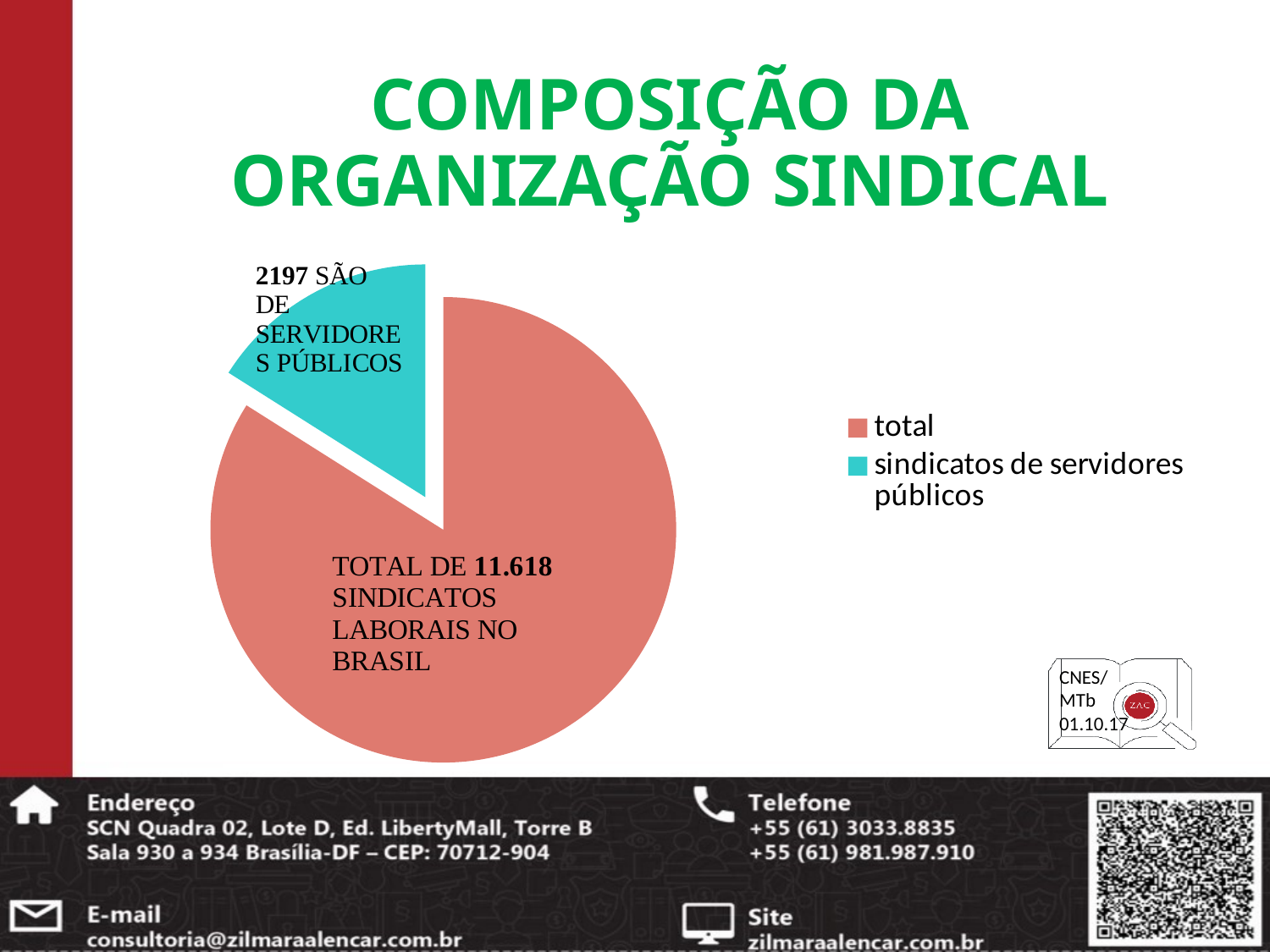
Which is larger in the pie chart: 'total' or 'sindicatos de servidores públicos'? total What value is printed for the 'sindicatos de servidores públicos' slice? 2197 Which slice of the pie chart is the largest? total How many slices does the pie chart have? 2 What is the title of the slide containing the pie chart? COMPOSIÇÃO DA ORGANIZAÇÃO SINDICAL Which slice of the pie chart is the smallest? sindicatos de servidores públicos What value is printed for the 'total' slice of the pie chart? 11.618 What colour is the 'sindicatos de servidores públicos' slice? teal How many entries does the legend of the pie chart list? 2 What kind of chart is shown on the slide? pie chart